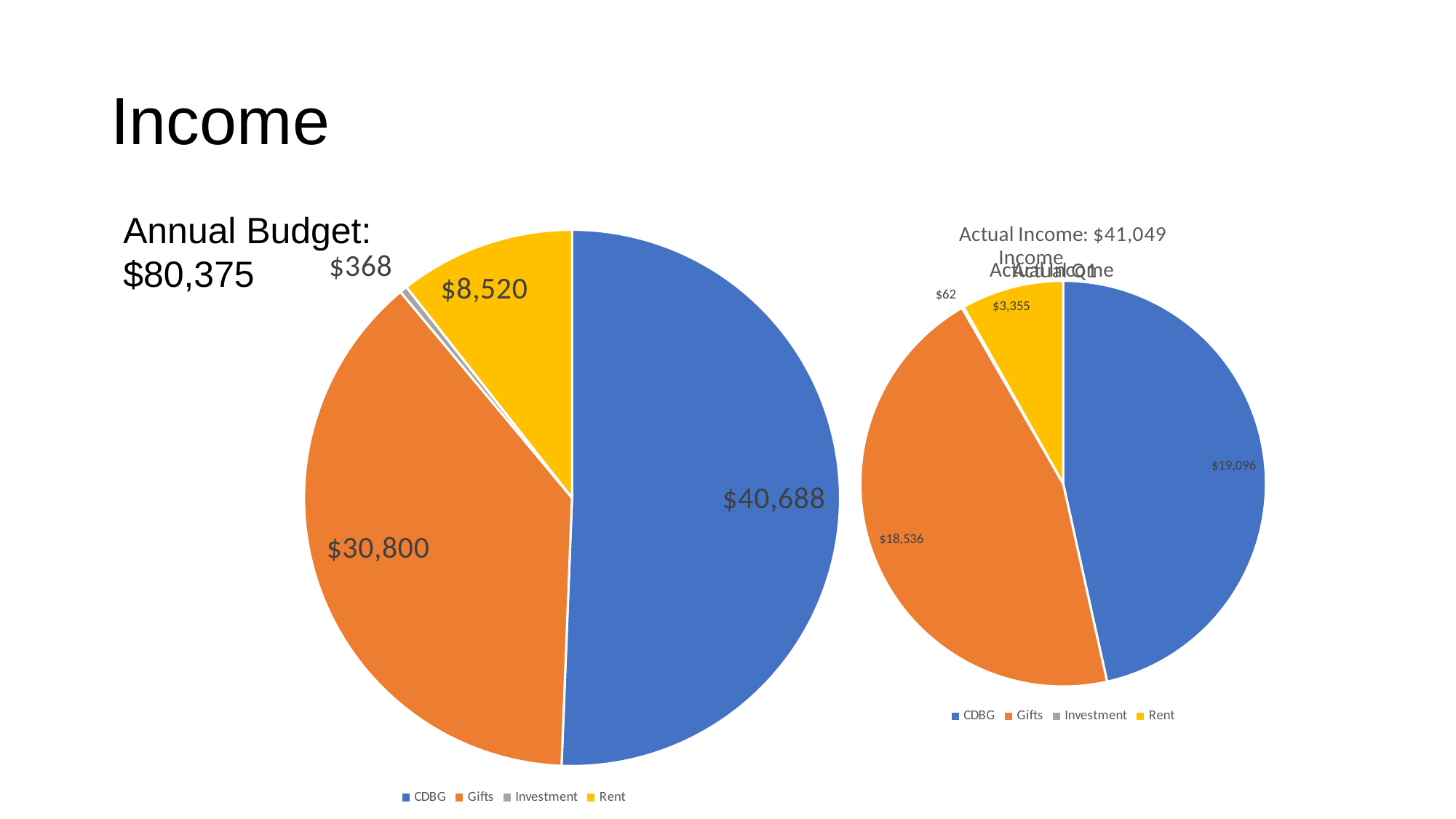
What total Actual Income is stated above the right pie chart? $41,049 In the right pie chart (Actual Income), what is the value for Investment? $62 In the left pie chart (Annual Budget), what is the difference between CDBG and Gifts? $9,888 In the right pie chart (Actual Income), what is the value for CDBG? $19,096 How many categories does the legend of the right pie chart list? 4 In the right pie chart (Actual Income), what is the difference between Rent and Investment? $3,293 What type of chart is the larger chart on the left of the slide? Pie chart In the left pie chart (Annual Budget), what is the value for Rent? $8,520 In the left pie chart (Annual Budget), what is the value for Gifts? $30,800 In the left pie chart (Annual Budget), what is the value for CDBG? $40,688 In the left pie chart (Annual Budget), which category has the smallest value? Investment In the right pie chart (Actual Income), which category has the largest value? CDBG